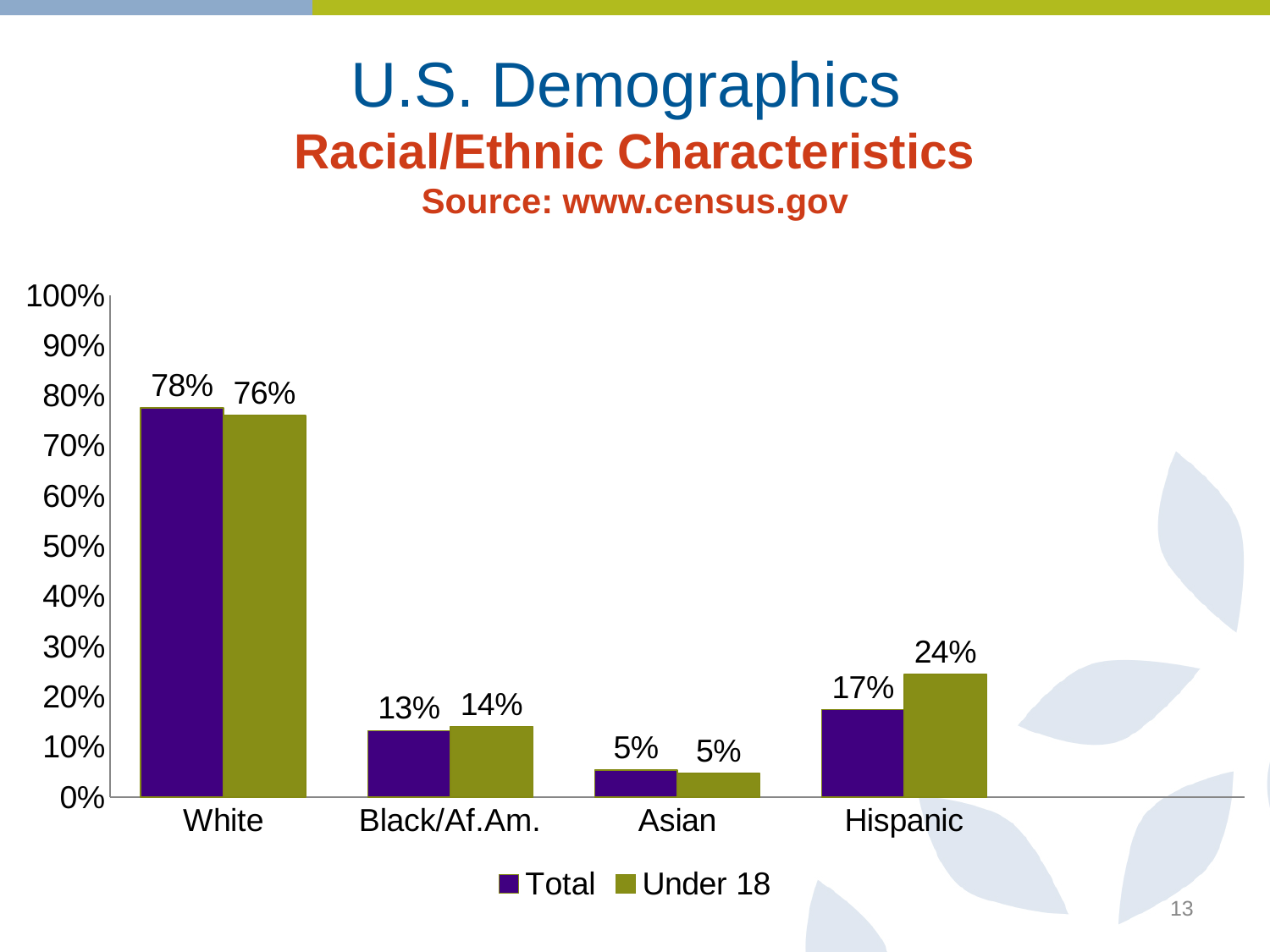
What is the Under 18 value for Hispanic? 24% Which category has the highest Total value? White Which is larger for White: the Total value or the Under 18 value? Total How many series does the legend list? 2 What kind of chart is shown on the slide? bar chart What is the Under 18 value for Black/Af.Am.? 14% What source is cited for the chart data? www.census.gov How many categories are shown on the x axis? 4 What is the difference between the Under 18 and Total values for Hispanic? 7% What is the Total value for White? 78% Which category has the lowest Under 18 value? Asian Is the Total value for Hispanic greater or less than 20%? less